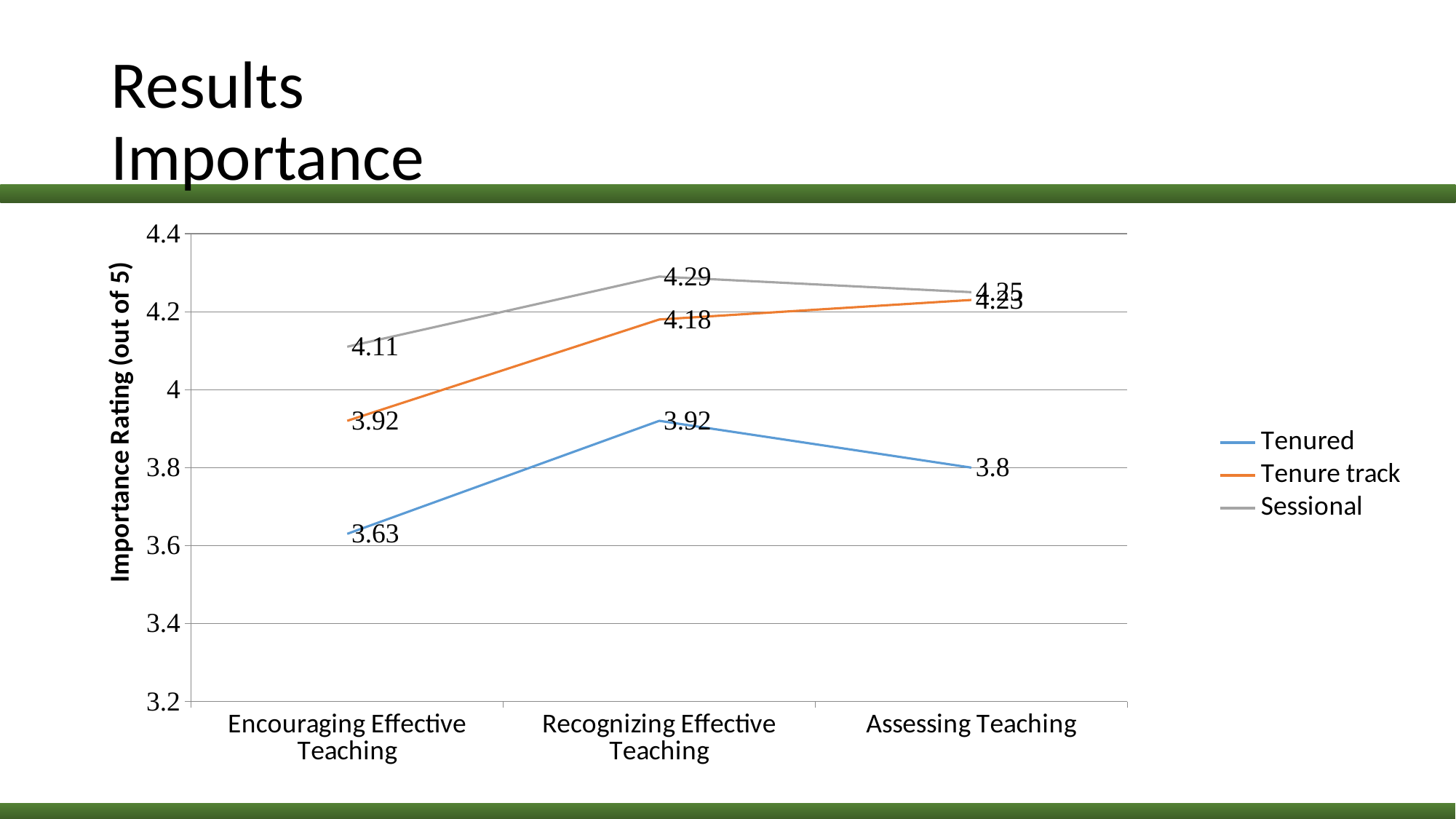
What is the Tenured value for Encouraging Effective Teaching? 3.63 For the Tenured series, which category has the highest value? Recognizing Effective Teaching What is the Sessional value for Recognizing Effective Teaching? 4.29 For Encouraging Effective Teaching, which is larger: the Tenured value or the Tenure track value? Tenure track What is the Tenured value for Assessing Teaching? 3.8 What is the Tenure track value for Recognizing Effective Teaching? 4.18 For the Tenured series, which category has the lowest value? Encouraging Effective Teaching How many series does the legend list? 3 What is the difference between the Sessional and Tenured values for Recognizing Effective Teaching? 0.37 What kind of chart is shown on the slide? line chart Do the Tenure track values rise or fall from Encouraging Effective Teaching to Assessing Teaching? rise How many categories are shown on the x axis? 3